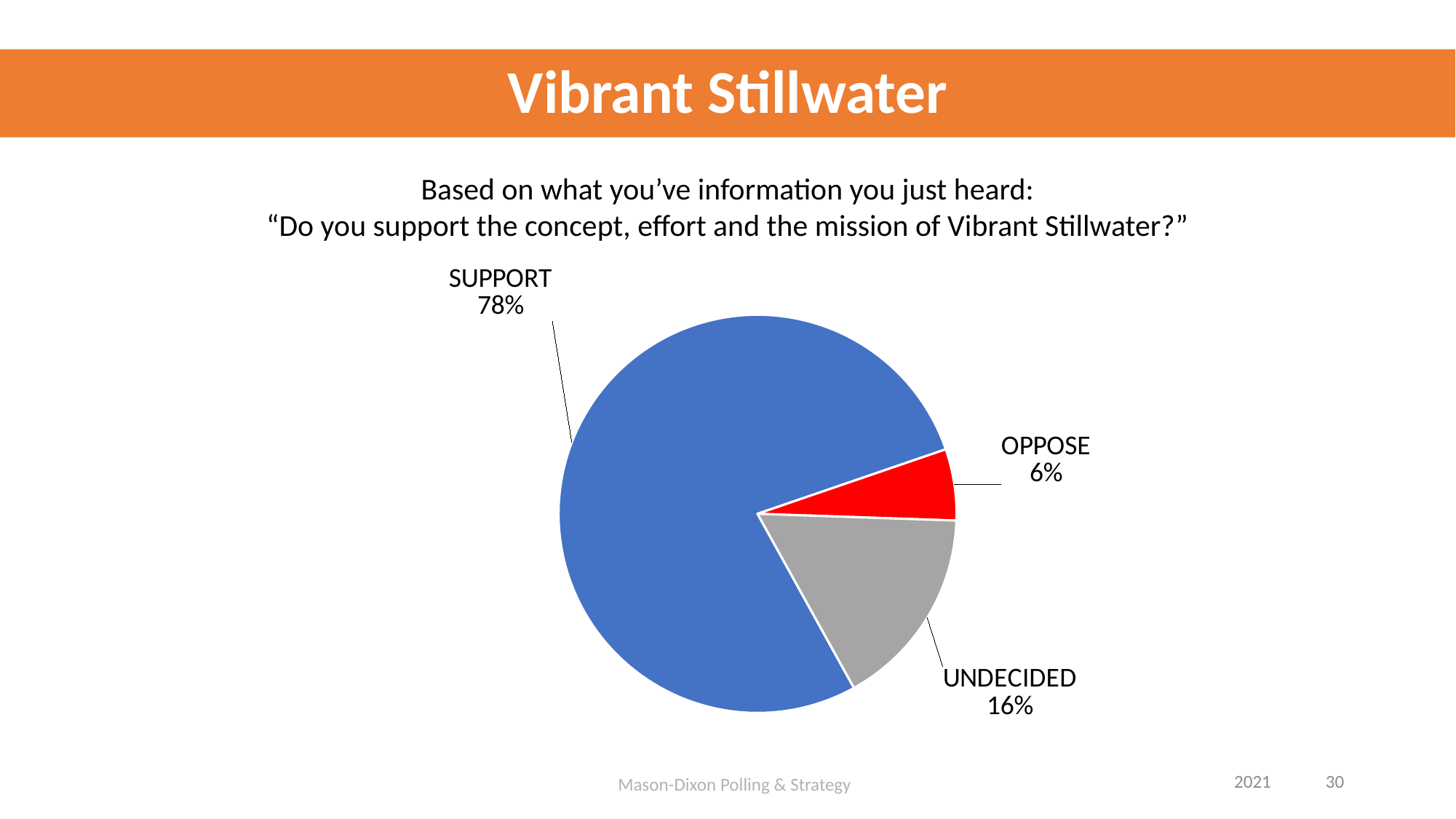
What colour is the SUPPORT slice? Blue Which response has the smallest share of the pie? OPPOSE What kind of chart is shown on the slide? Pie chart What colour is the OPPOSE slice? Red How many slices does the pie chart have? 3 What percentage of respondents said OPPOSE? 6% Which is larger, the UNDECIDED share or the OPPOSE share? UNDECIDED Which response has the largest share of the pie? SUPPORT What is the difference in percentage points between UNDECIDED and OPPOSE? 10 What percentage of respondents said SUPPORT? 78% What percentage of respondents were UNDECIDED? 16% What is the difference in percentage points between SUPPORT and OPPOSE? 72